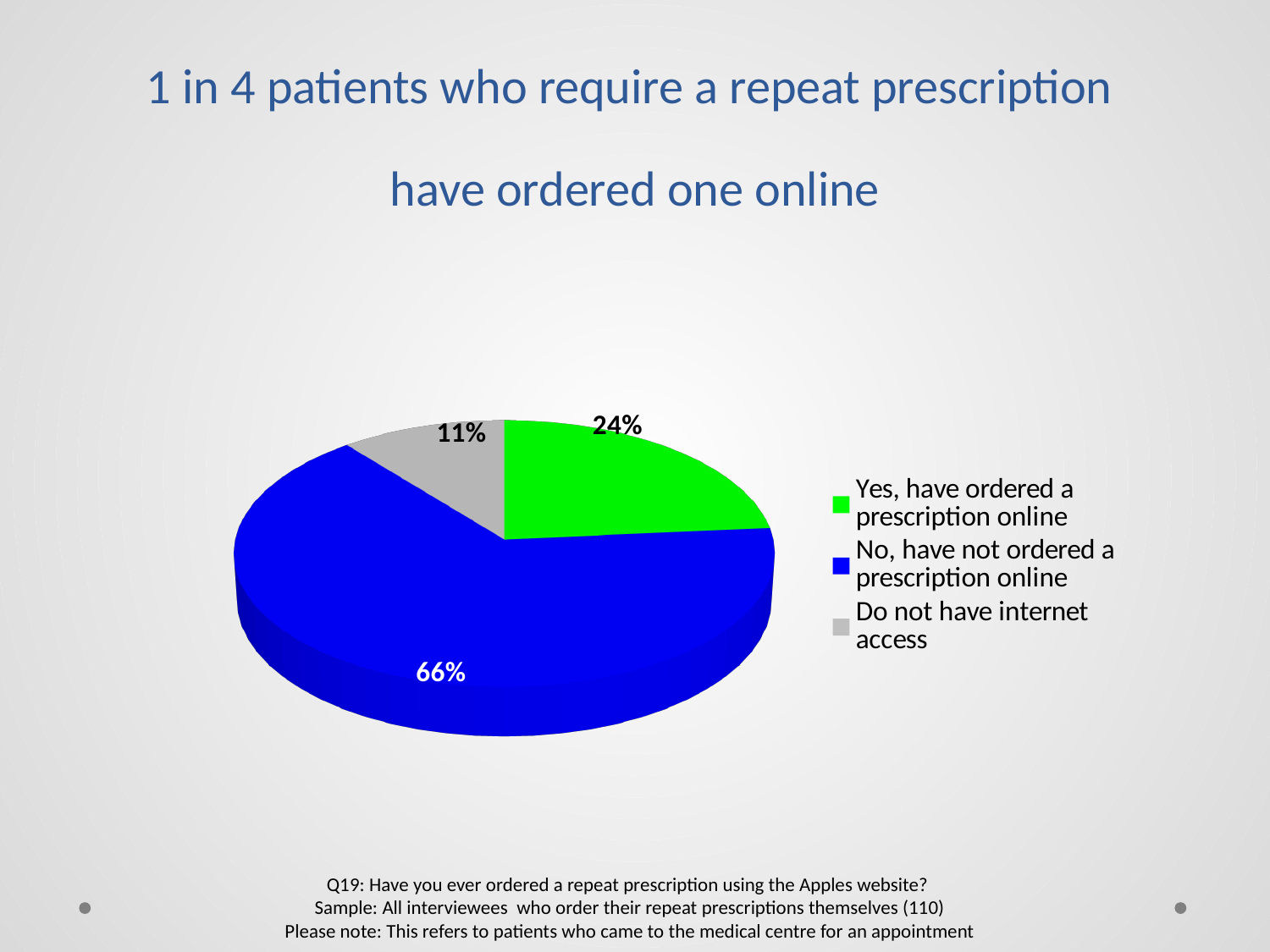
What is the sample size stated on the slide? 110 What is the difference in percentage points between those who have not ordered a prescription online and those who have? 42 Which is larger: the share who have ordered a prescription online or the share who do not have internet access? Yes, have ordered a prescription online What percentage of patients do not have internet access? 11% Which category has the largest share of the pie? No, have not ordered a prescription online What kind of chart is shown on the slide? Pie chart How many categories does the pie chart show? 3 What colour is the slice for patients who have not ordered a prescription online? Blue What percentage of patients have ordered a prescription online? 24% Which category has the smallest share of the pie? Do not have internet access What percentage of patients have not ordered a prescription online? 66%